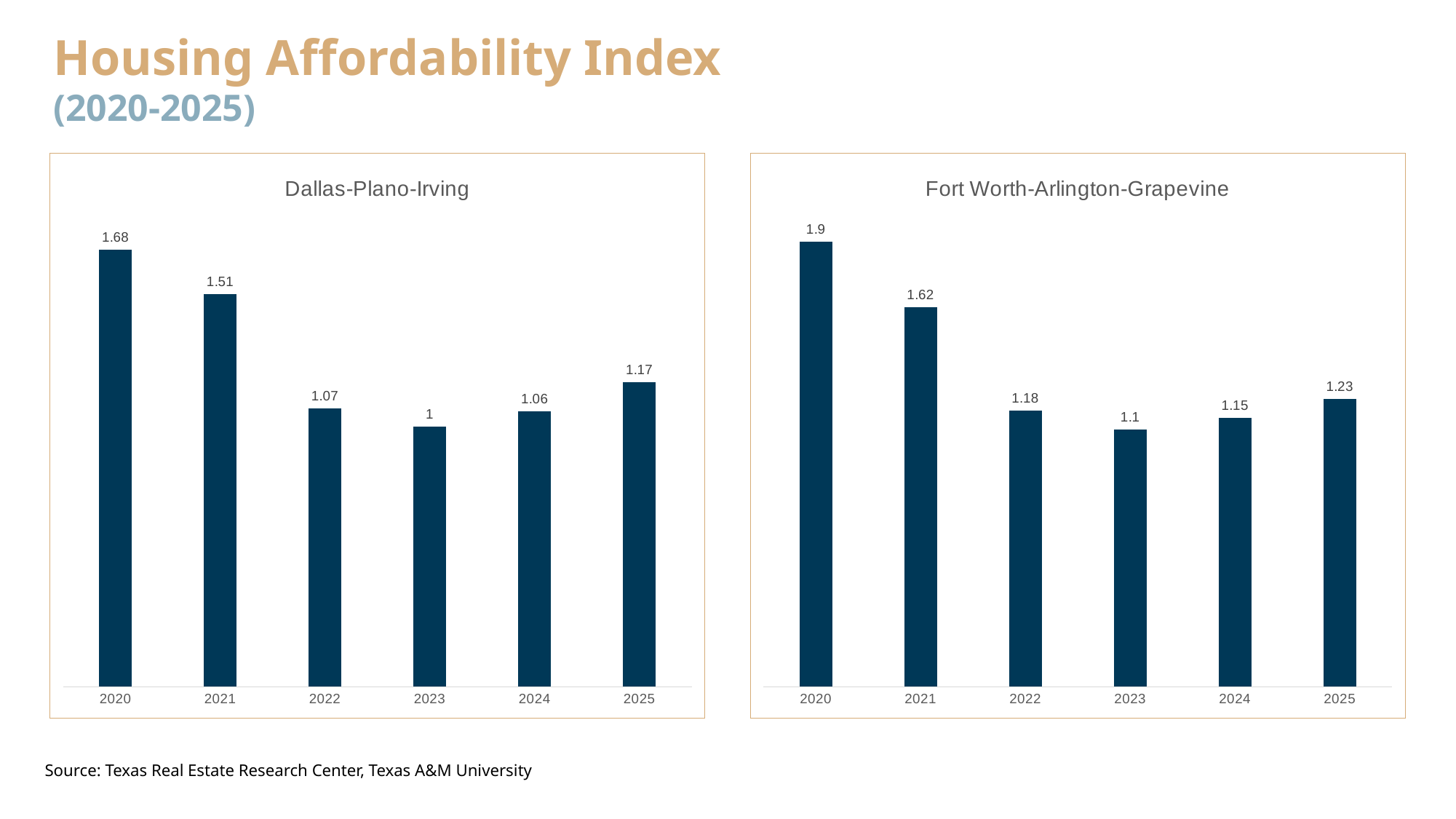
What kind of chart is the Fort Worth-Arlington-Grapevine chart? Bar chart What is the title of the chart on the right side of the slide? Fort Worth-Arlington-Grapevine How many years are shown in the Dallas-Plano-Irving chart? 6 In the Dallas-Plano-Irving chart, do the values rise or fall from 2020 to 2023? Fall In the Fort Worth-Arlington-Grapevine chart, which year has the highest value? 2020 In the Dallas-Plano-Irving chart, what is the value for 2020? 1.68 In the Dallas-Plano-Irving chart, which year has the lowest value? 2023 In the Fort Worth-Arlington-Grapevine chart, what is the value for 2023? 1.1 In the Dallas-Plano-Irving chart, what is the difference between the 2020 and 2021 values? 0.17 In the Dallas-Plano-Irving chart, which is larger, the value for 2022 or the value for 2025? 2025 In the Fort Worth-Arlington-Grapevine chart, what is the difference between the 2020 and 2025 values? 0.67 In the Fort Worth-Arlington-Grapevine chart, which is larger, the value for 2021 or the value for 2022? 2021